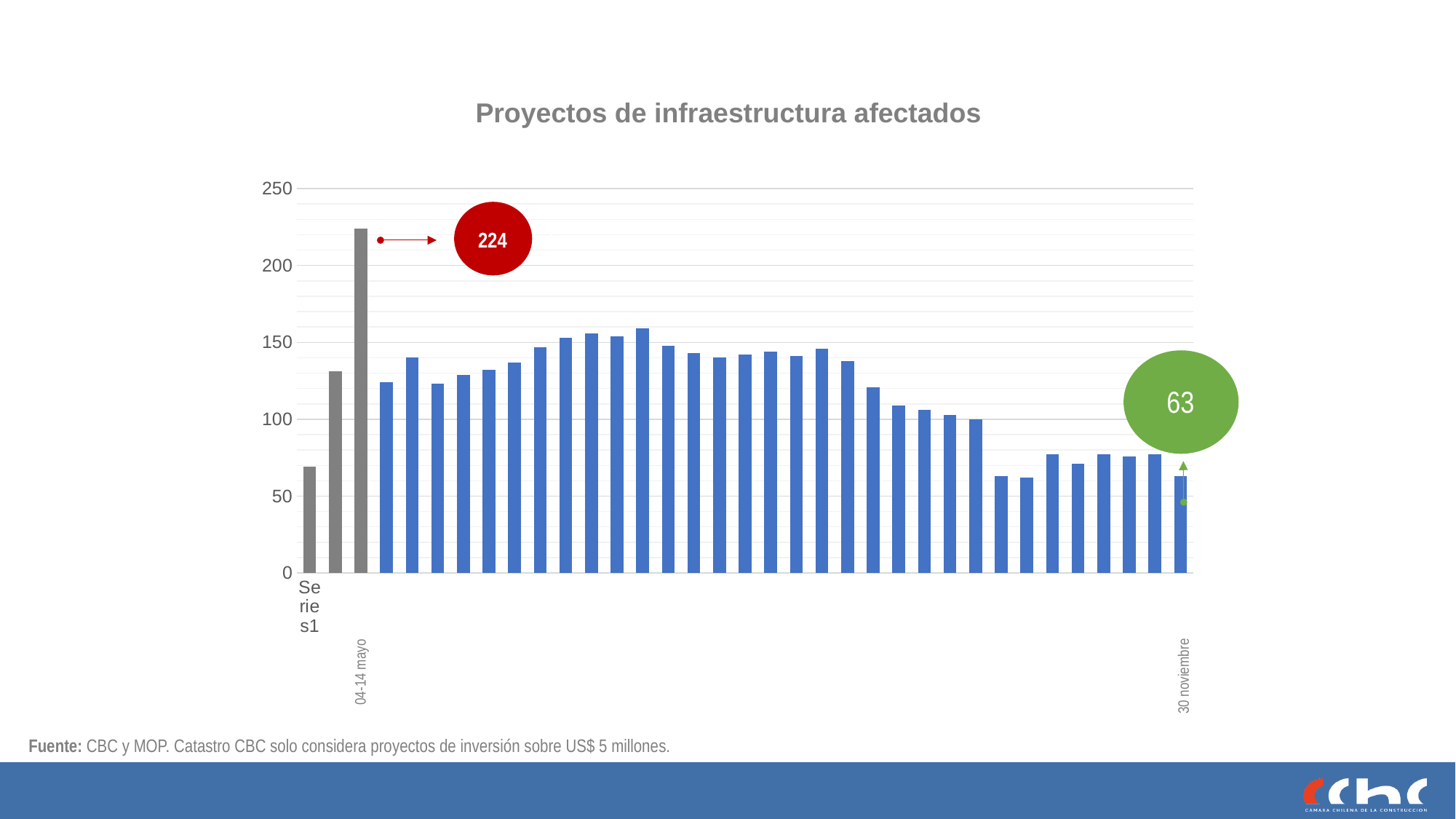
What kind of chart is shown on the slide? bar chart What is the value for 30 noviembre? 63 Is the value for 30 noviembre greater or less than 100? less Which is larger, the value for 04-14 mayo or the value for 30 noviembre? 04-14 mayo Which category has the highest value in the chart? 04-14 mayo Overall, do the values rise or fall from 04-14 mayo to 30 noviembre? fall What is the title of the chart? Proyectos de infraestructura afectados What is the difference between the value for 04-14 mayo and the value for 30 noviembre? 161 What colour is the callout circle showing the value 224? red What is the value for 04-14 mayo? 224 Is the value for 04-14 mayo greater or less than 200? greater